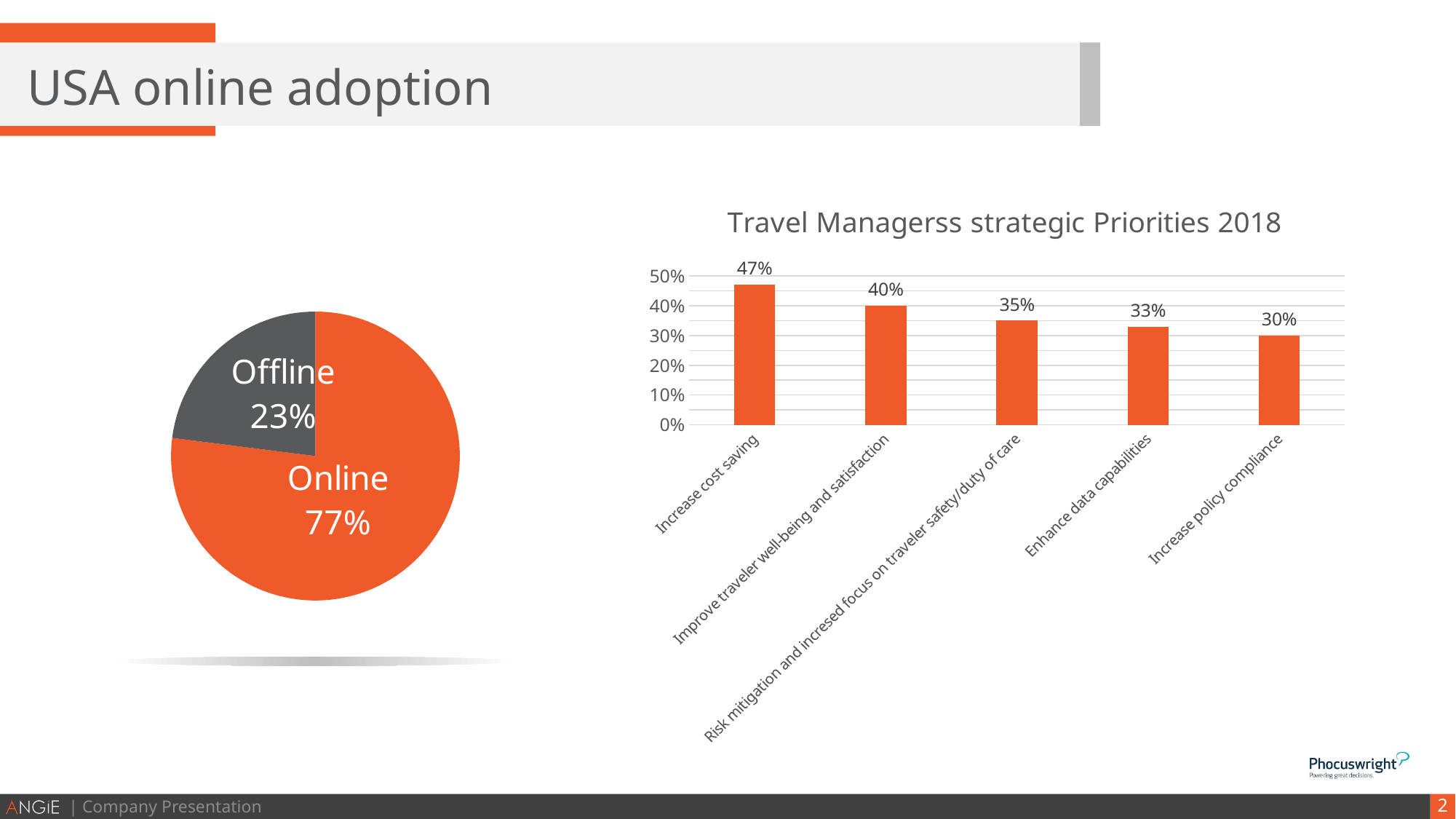
In the 'Travel Managerss strategic Priorities 2018' chart, what is the difference between Increase cost saving and Improve traveler well-being and satisfaction? 7% In the 'Travel Managerss strategic Priorities 2018' chart, what is the value for Increase cost saving? 47% In the pie chart on the left, what share is Online? 77% What kind of chart is 'Travel Managerss strategic Priorities 2018'? Bar chart In the 'Travel Managerss strategic Priorities 2018' chart, which category has the lowest value? Increase policy compliance In the 'Travel Managerss strategic Priorities 2018' chart, how many categories are shown? 5 In the pie chart on the left, what share is Offline? 23% In the 'Travel Managerss strategic Priorities 2018' chart, what is the value for Enhance data capabilities? 33% In the pie chart on the left, which slice is larger, Online or Offline? Online In the 'Travel Managerss strategic Priorities 2018' chart, which category has the highest value? Increase cost saving In the 'Travel Managerss strategic Priorities 2018' chart, do the values rise or fall from left to right? Fall In the pie chart on the left, how many slices are there? 2